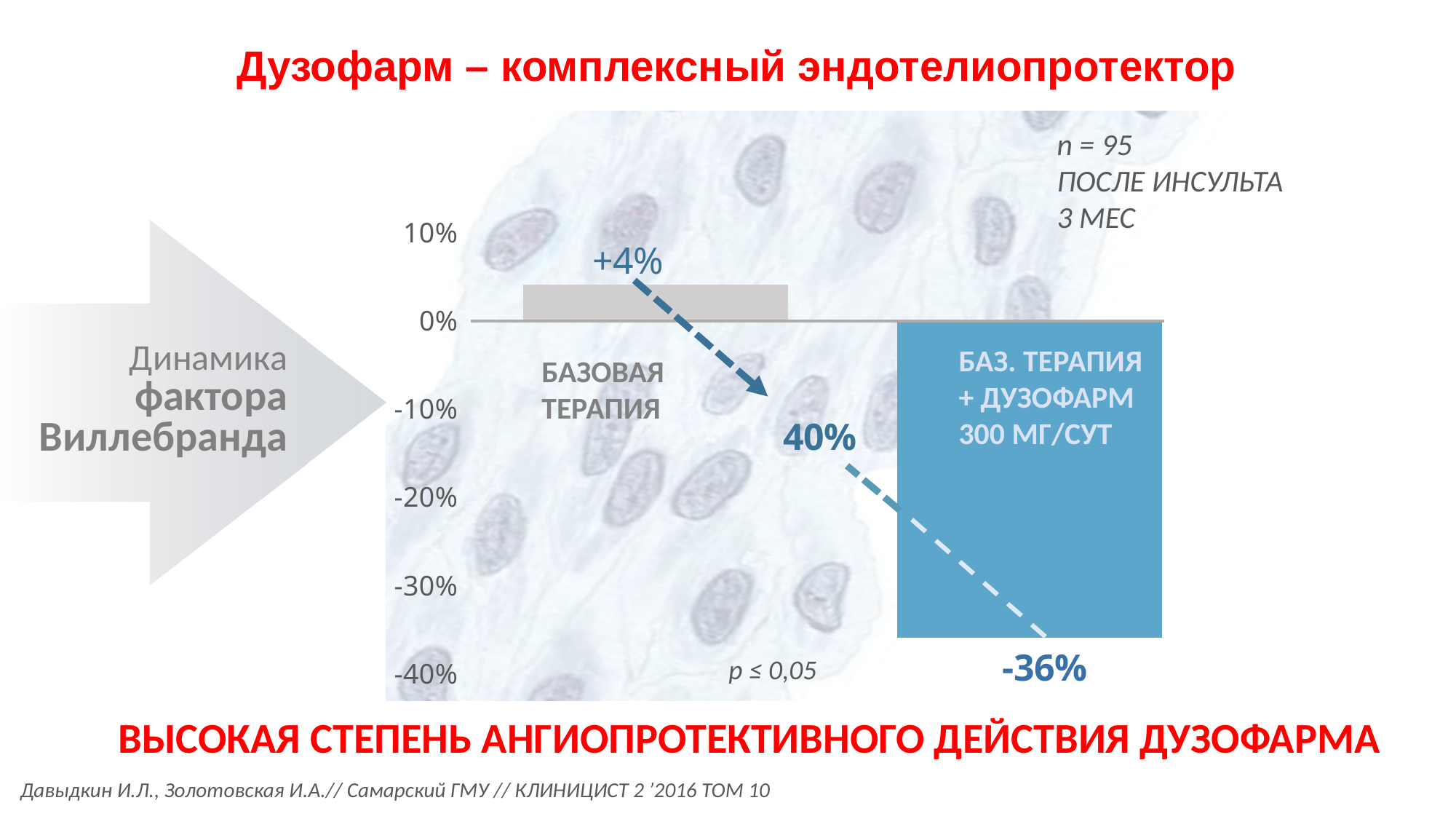
What is the lowest value shown on the vertical axis of the chart? -40% Is the value for БАЗ. ТЕРАПИЯ + ДУЗОФАРМ greater or less than -30%? less What kind of chart is shown on the slide? bar chart Which bar has the lowest value? БАЗ. ТЕРАПИЯ + ДУЗОФАРМ 300 МГ/СУТ Which is larger, the value for БАЗОВАЯ ТЕРАПИЯ or the value for БАЗ. ТЕРАПИЯ + ДУЗОФАРМ? БАЗОВАЯ ТЕРАПИЯ What is the difference between the БАЗОВАЯ ТЕРАПИЯ value and the БАЗ. ТЕРАПИЯ + ДУЗОФАРМ value? 40% Which bar has the highest value? БАЗОВАЯ ТЕРАПИЯ What sample size (n) is stated on the chart? n = 95 What is the value shown for the БАЗОВАЯ ТЕРАПИЯ bar? +4% How many bars are plotted in the chart? 2 Is the value for БАЗОВАЯ ТЕРАПИЯ greater or less than 0%? greater What is the value shown for the БАЗ. ТЕРАПИЯ + ДУЗОФАРМ 300 МГ/СУТ bar? -36%